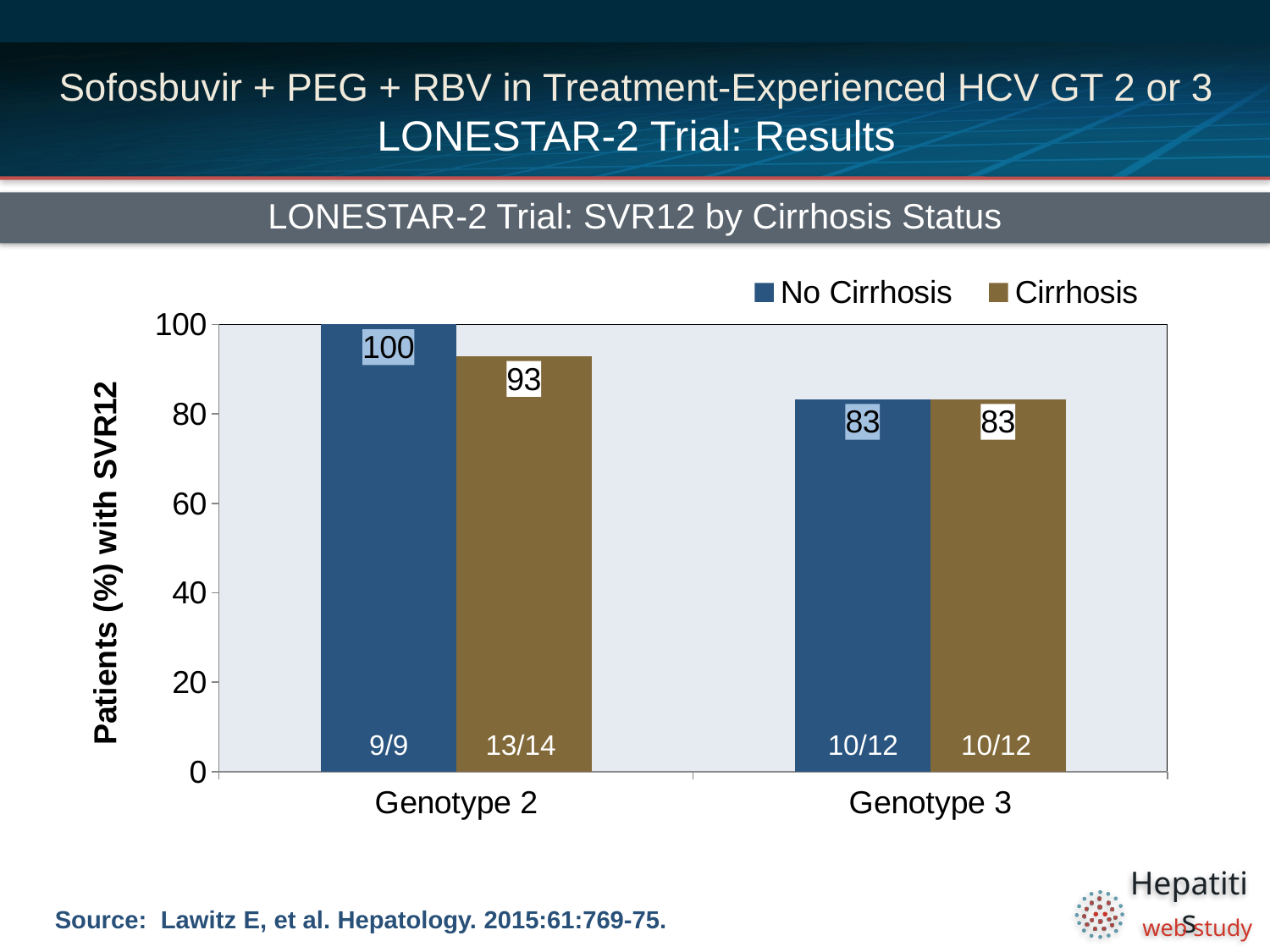
What is the title of the chart? LONESTAR-2 Trial: SVR12 by Cirrhosis Status What is the SVR12 rate for No Cirrhosis patients with Genotype 3? 83 How many series does the legend list? 2 What is the SVR12 rate for Cirrhosis patients with Genotype 3? 83 How many genotype categories are shown on the x axis? 2 What is the patient fraction shown for Cirrhosis patients with Genotype 2? 13/14 Which is larger for Genotype 2: the SVR12 rate for No Cirrhosis or for Cirrhosis? No Cirrhosis What is the SVR12 rate for No Cirrhosis patients with Genotype 2? 100 What is the difference in SVR12 rate between No Cirrhosis and Cirrhosis patients with Genotype 2? 7 What is the SVR12 rate for Cirrhosis patients with Genotype 2? 93 Which bar has the highest SVR12 rate? No Cirrhosis, Genotype 2 What kind of chart is shown? Bar chart